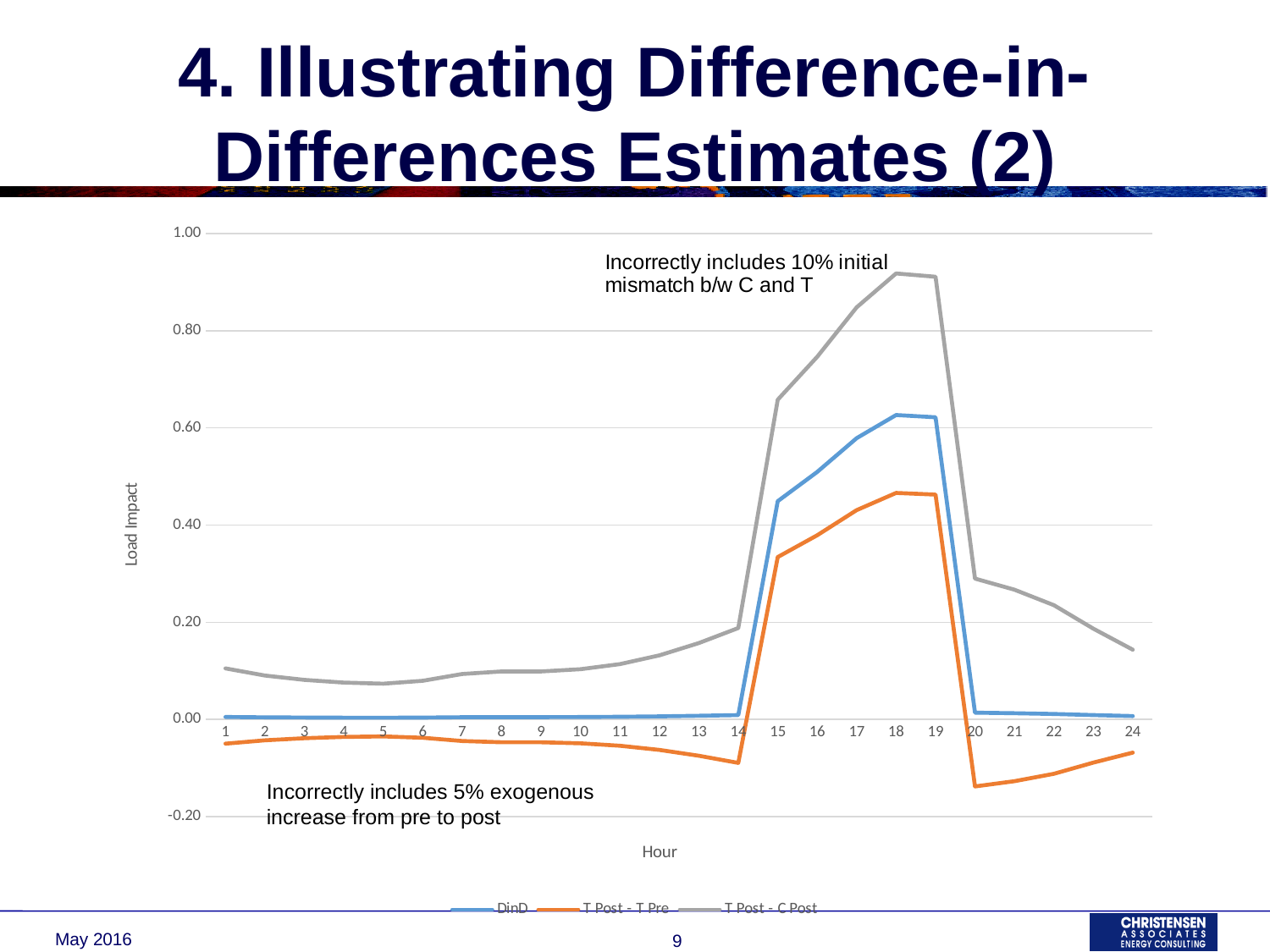
Is the value of T Post - C Post at hour 1 greater or less than 0.20? less Which series has the highest value at hour 18? T Post - C Post Is the value of T Post - C Post at hour 18 greater or less than 0.80? greater Is the value of T Post - T Pre at hour 20 greater or less than 0.00? less How many hours are plotted along the x axis? 24 What is the label of the x axis? Hour How many series does the legend list? 3 Do the values of all three series rise or fall from hour 14 to hour 15? rise What is the label of the y axis? Load Impact Which series has the lowest value at hour 20? T Post - T Pre What kind of chart is shown on the slide? Line chart